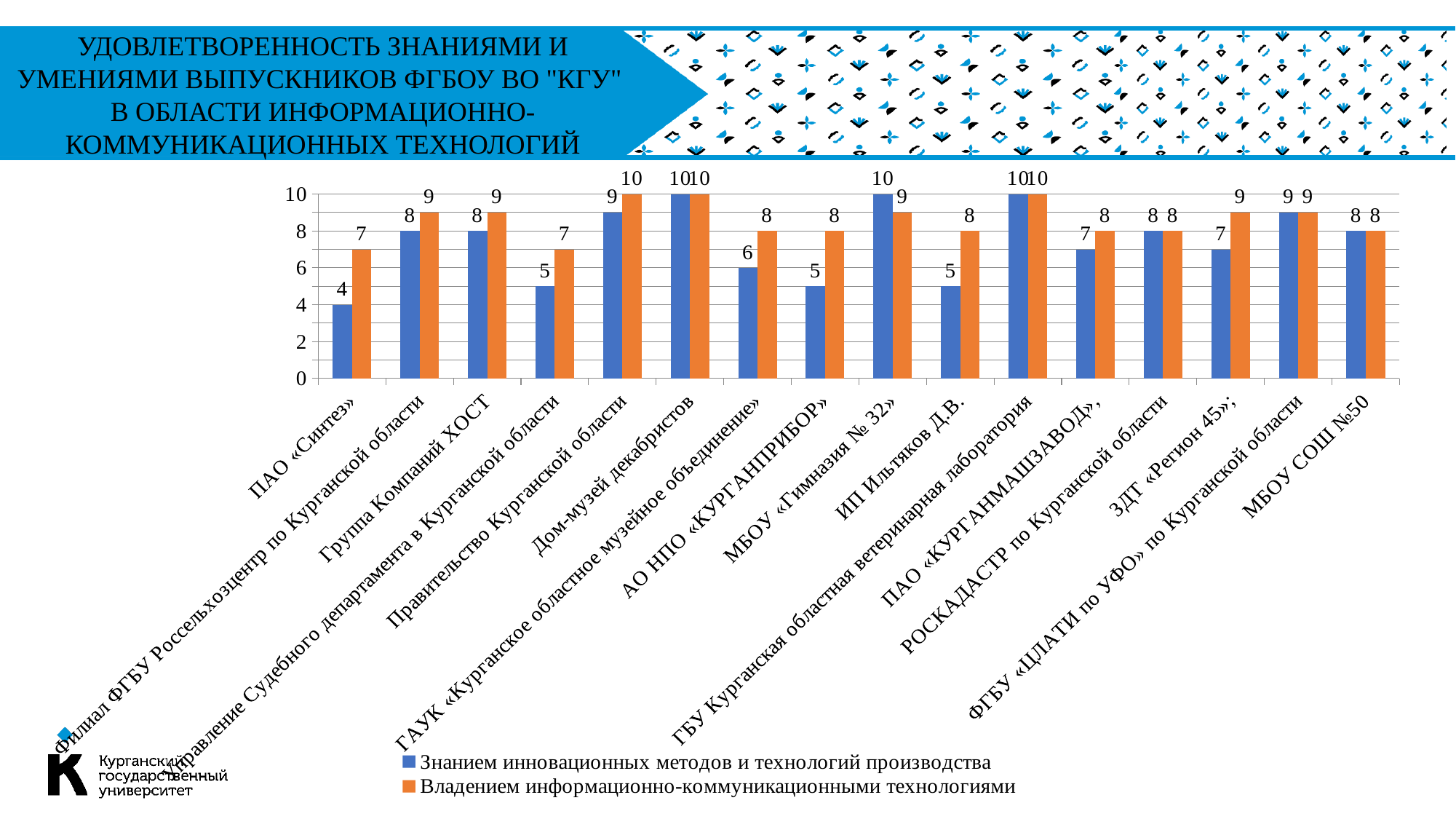
What is the value for ПАО «Синтез» in the series 'Знанием инновационных методов и технологий производства'? 4 How many series does the legend list? 2 For МБОУ «Гимназия № 32», which series has the larger value? Знанием инновационных методов и технологий производства What kind of chart is shown on the slide? bar chart How many categories are shown on the x axis? 16 For Правительство Курганской области, which series has the larger value? Владением информационно-коммуникационными технологиями What is the difference between the two series values for ПАО «Синтез»? 3 What is the value for ЗДТ «Регион 45» in the series 'Владением информационно-коммуникационными технологиями'? 9 What is the difference between the two series values for ИП Ильтяков Д.В.? 3 Which category has the lowest value in the series 'Знанием инновационных методов и технологий производства'? ПАО «Синтез» What is the value for МБОУ «Гимназия № 32» in the series 'Знанием инновационных методов и технологий производства'? 10 What is the value for АО НПО «КУРГАНПРИБОР» in the series 'Владением информационно-коммуникационными технологиями'? 8